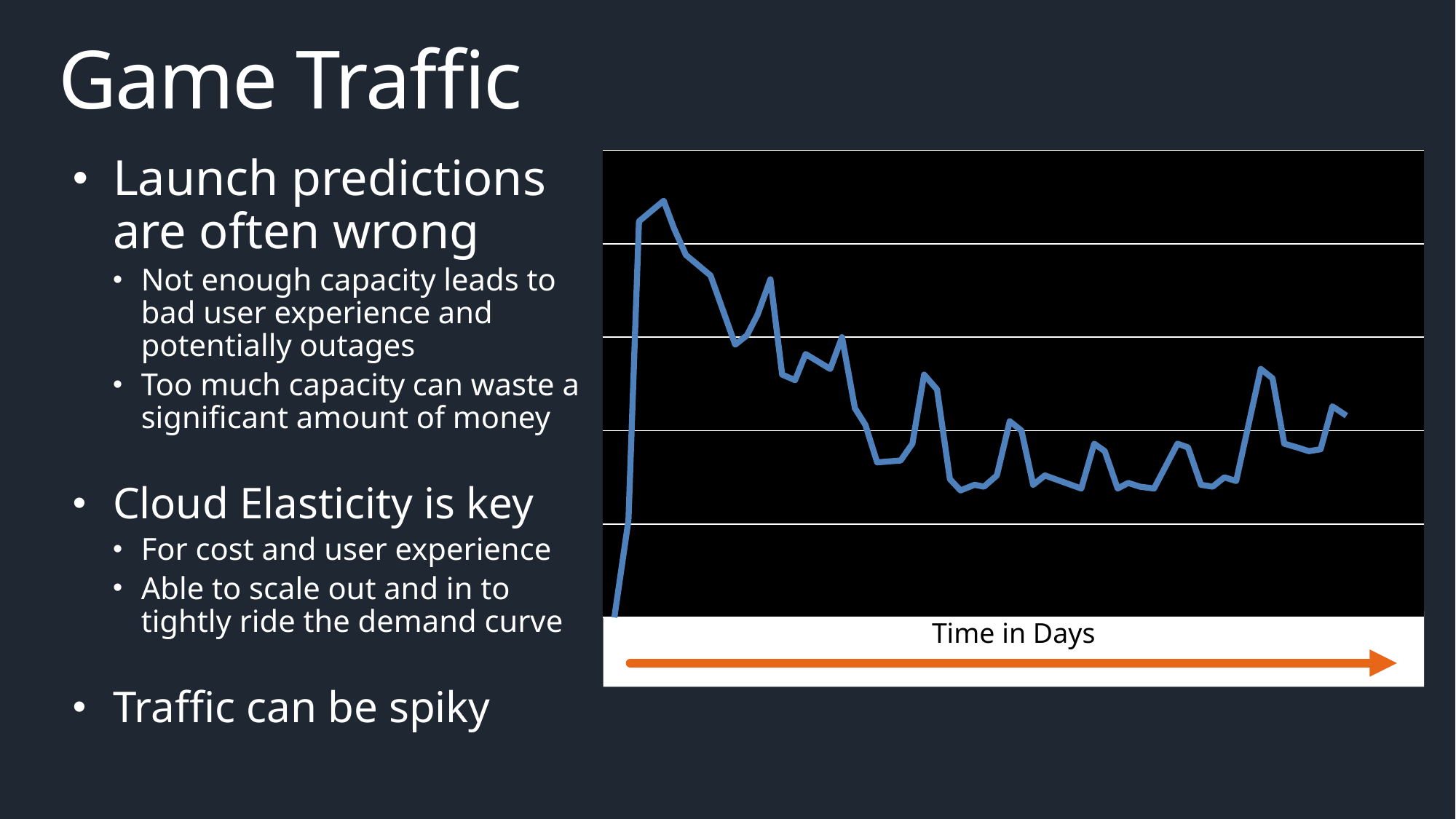
What colour is the plotted line in the chart? blue What kind of chart is shown on the slide? line chart Is the highest point of the line near the start or near the end of the time axis? near the start How many data series are plotted in the chart? 1 What is the label on the x axis of the chart? Time in Days After the initial peak near the start, does the line generally rise or fall as time in days increases? fall